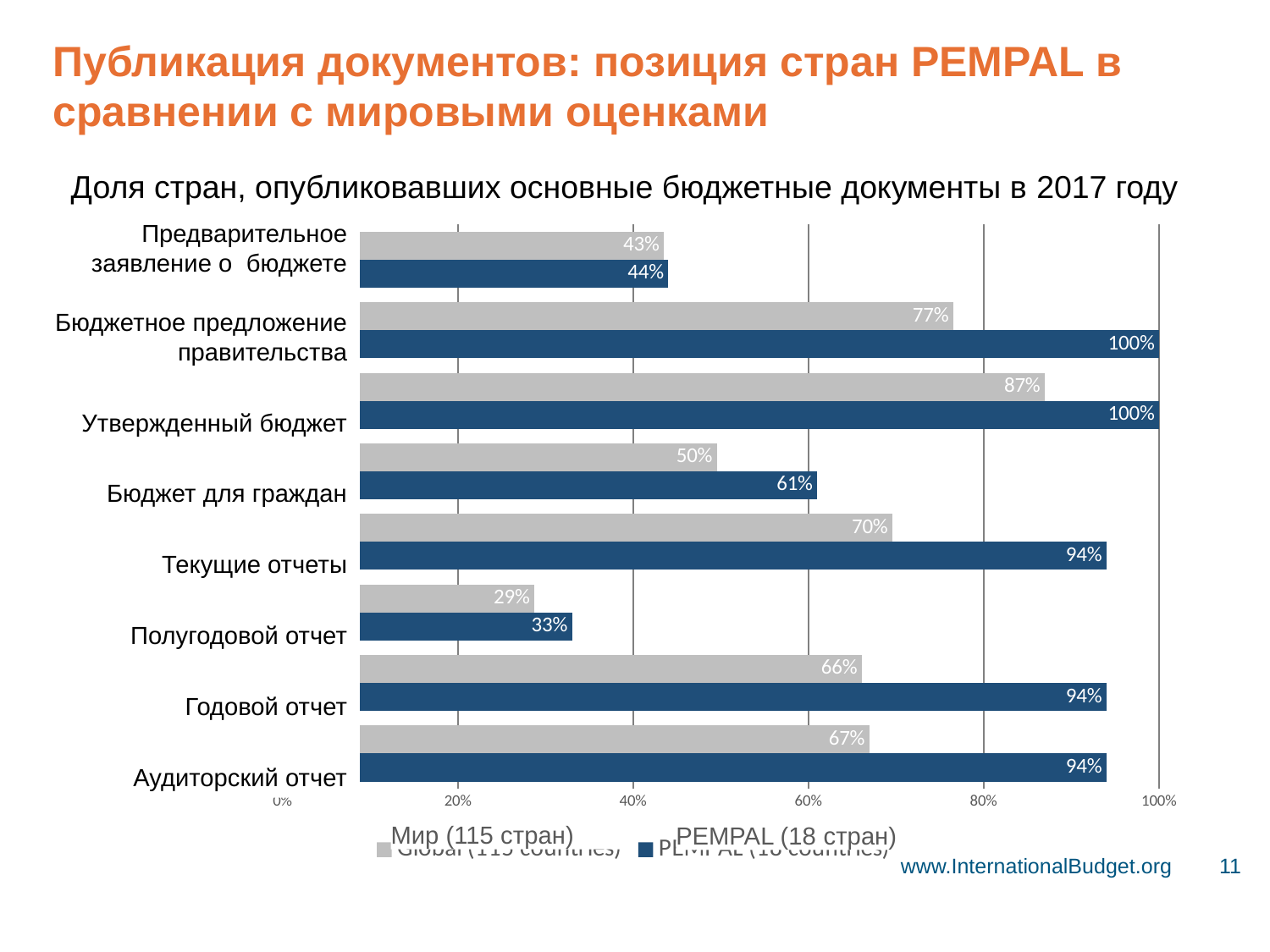
What is the difference between the PEMPAL (18 стран) and Мир (115 стран) values for Бюджетное предложение правительства? 23% What is the value for Мир (115 стран) for Утвержденный бюджет? 87% Which category has the lowest value for PEMPAL (18 стран)? Полугодовой отчет What is the value for Мир (115 стран) for Полугодовой отчет? 29% What is the difference between the PEMPAL (18 стран) and Мир (115 стран) values for Текущие отчеты? 24% Which category has the highest value for Мир (115 стран)? Утвержденный бюджет Which colour represents the PEMPAL (18 стран) series? Blue Which is larger for Годовой отчет: the value for Мир (115 стран) or for PEMPAL (18 стран)? PEMPAL (18 стран) What is the value for PEMPAL (18 стран) for Бюджет для граждан? 61% How many categories are shown on the chart? 8 How many series does the legend list? 2 What kind of chart is shown on the slide? Bar chart